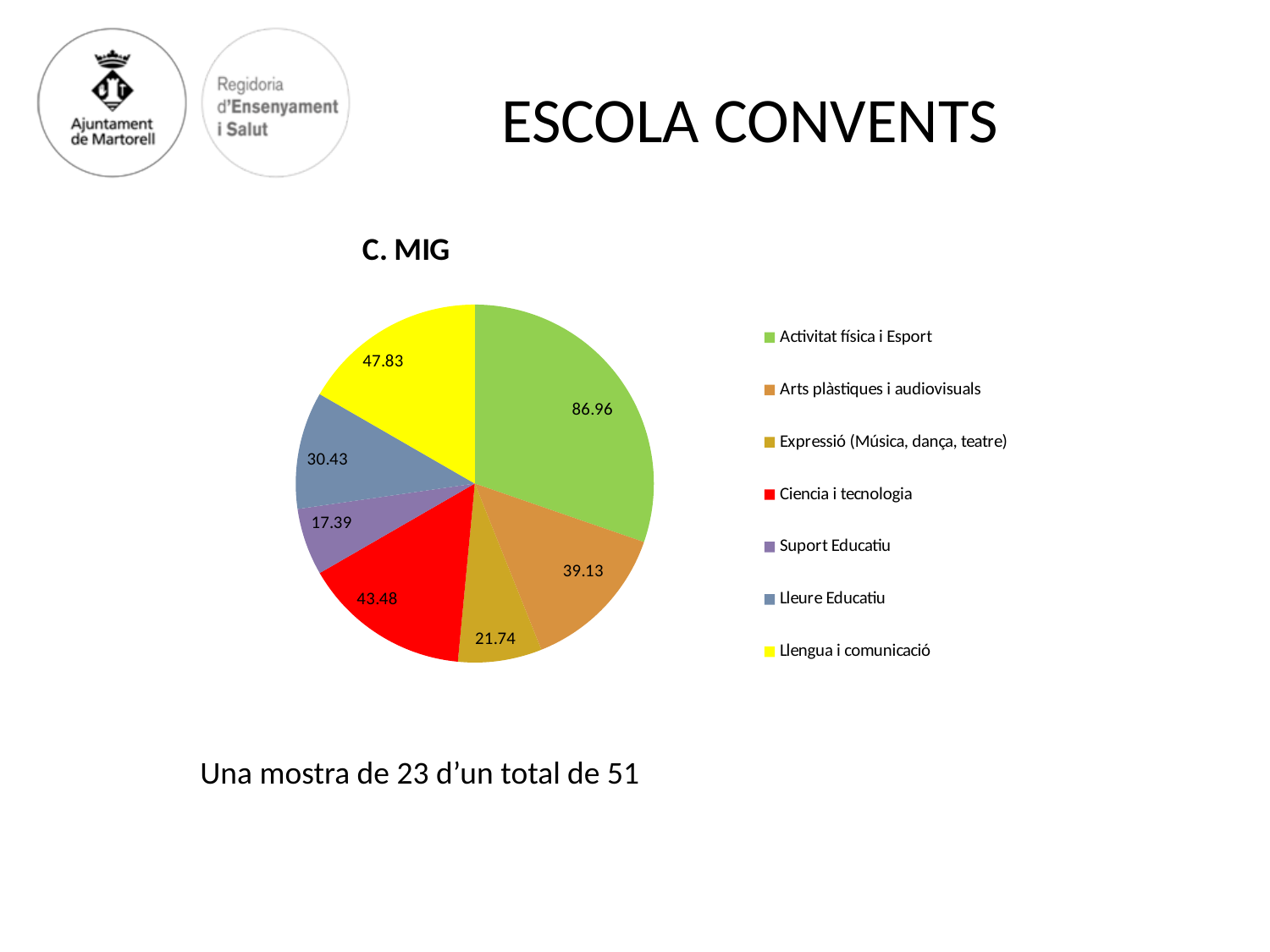
Which category has the largest slice in the C. MIG pie chart? Activitat física i Esport What kind of chart is shown on the slide? Pie chart How many categories are shown in the C. MIG pie chart? 7 What is the value for Expressió (Música, dança, teatre) in the C. MIG pie chart? 21.74 What colour is the slice for Ciencia i tecnologia in the C. MIG pie chart? Red What is the value for Suport Educatiu in the C. MIG pie chart? 17.39 What is the value for Activitat física i Esport in the C. MIG pie chart? 86.96 What is the difference between the values for Lleure Educatiu and Suport Educatiu in the C. MIG pie chart? 13.04 What is the value for Llengua i comunicació in the C. MIG pie chart? 47.83 What is the difference between the values for Activitat física i Esport and Arts plàstiques i audiovisuals in the C. MIG pie chart? 47.83 Which category has the smallest slice in the C. MIG pie chart? Suport Educatiu Which is larger in the C. MIG pie chart: Ciencia i tecnologia or Arts plàstiques i audiovisuals? Ciencia i tecnologia